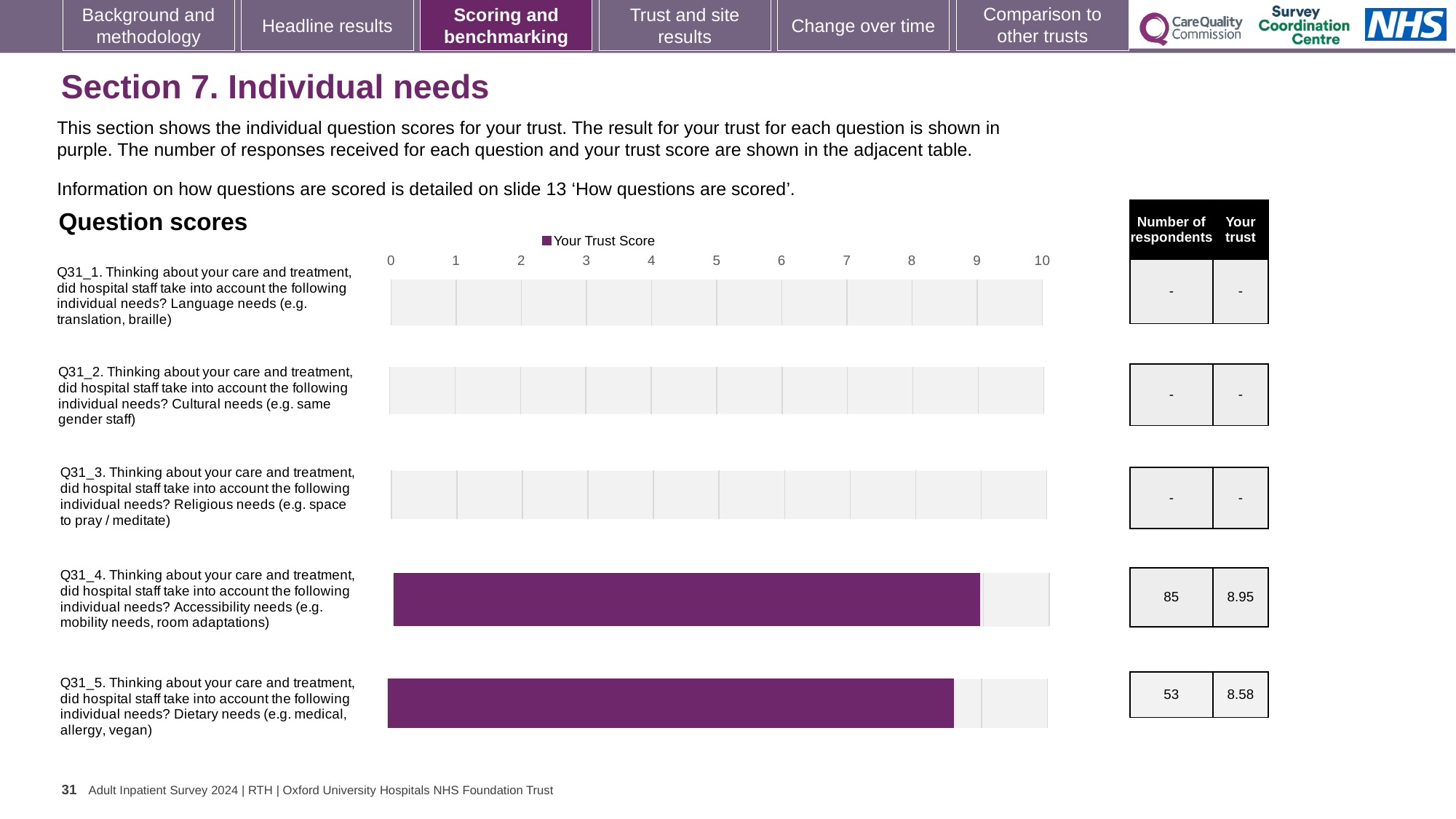
How many series does the chart legend list? 1 Which has a higher trust score, Q31_4 (Accessibility needs) or Q31_5 (Dietary needs)? Q31_4 (Accessibility needs) What is the difference between the trust scores for Q31_4 and Q31_5? 0.37 How many respondents answered Q31_4 (Accessibility needs)? 85 How many respondents answered Q31_5 (Dietary needs)? 53 How many questions are listed on the chart? 5 What is the trust score for Q31_4 (Accessibility needs)? 8.95 What is the name of the series shown in the chart legend? Your Trust Score Is the trust score for Q31_5 (Dietary needs) greater or less than 8? greater What kind of chart is shown on the slide? Bar chart Which question has the highest trust score shown on the chart? Q31_4 (Accessibility needs) What is the trust score for Q31_5 (Dietary needs)? 8.58